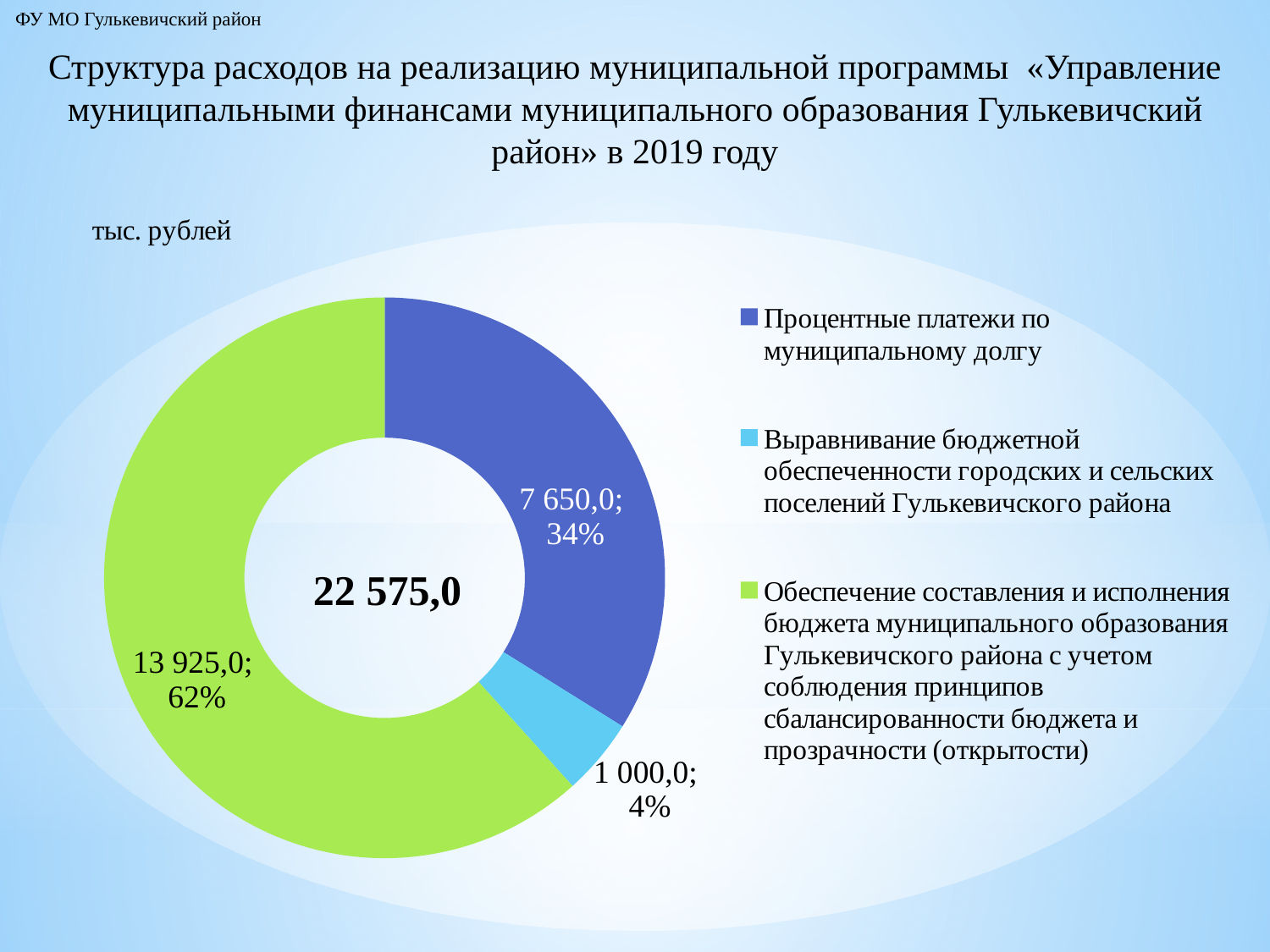
What is the difference between the values for «Обеспечение составления и исполнения бюджета...» and «Процентные платежи по муниципальному долгу»? 6 275,0 What is the value for «Процентные платежи по муниципальному долгу»? 7 650,0 What is the value for «Выравнивание бюджетной обеспеченности городских и сельских поселений Гулькевичского района»? 1 000,0 What is the value for «Обеспечение составления и исполнения бюджета муниципального образования Гулькевичского района...»? 13 925,0 What kind of chart is shown on the slide? Doughnut (pie) chart What share of the total does «Процентные платежи по муниципальному долгу» represent? 34% How many categories does the chart show? 3 What share of the total does «Выравнивание бюджетной обеспеченности городских и сельских поселений» represent? 4% Which category has the largest share of expenditures? Обеспечение составления и исполнения бюджета муниципального образования Гулькевичского района In what units are the values on the chart given? тыс. рублей Which category has the smallest share of expenditures? Выравнивание бюджетной обеспеченности городских и сельских поселений Гулькевичского района What is the total shown in the centre of the chart? 22 575,0